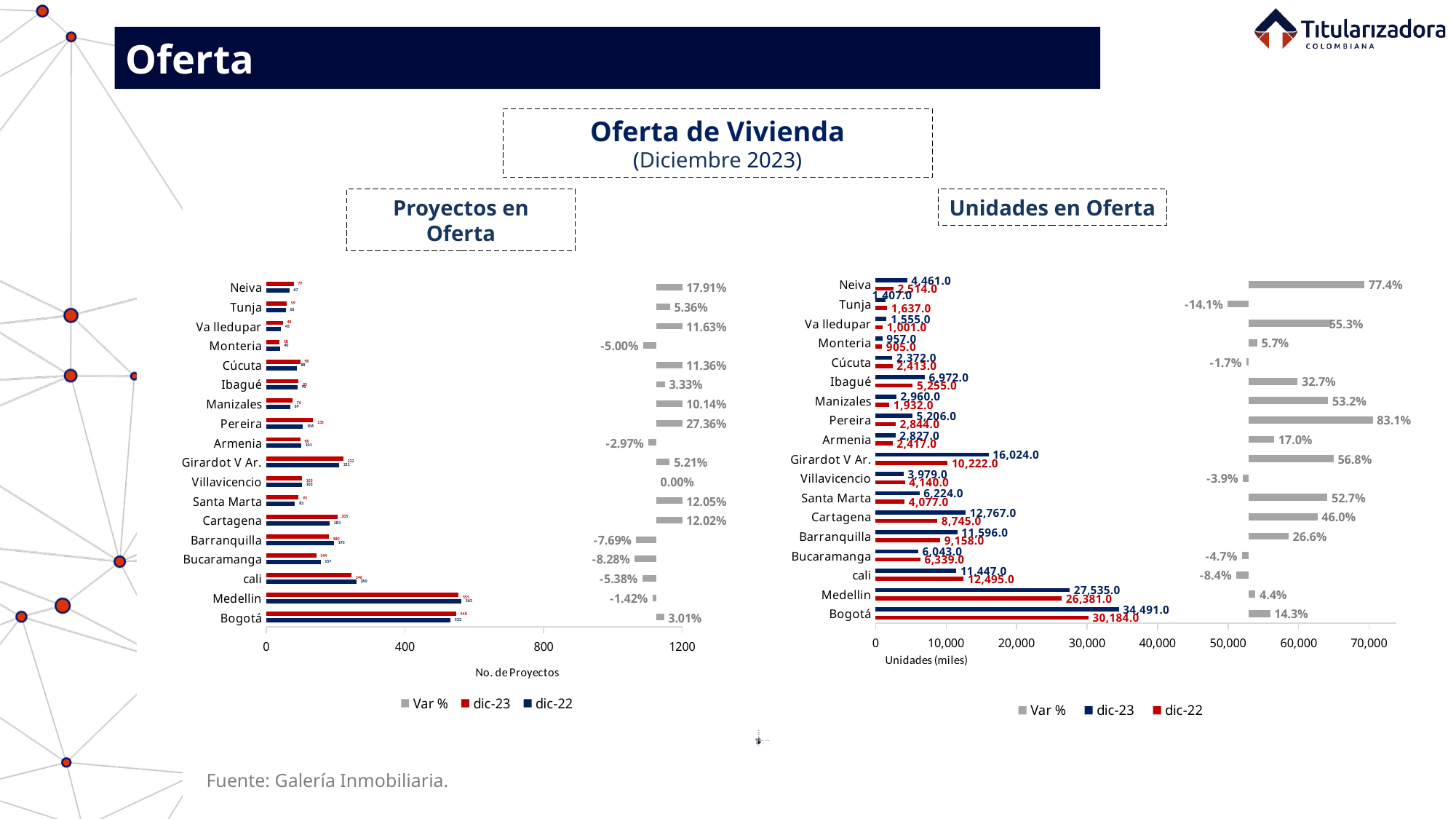
In the Unidades en Oferta chart, what is the Var % for Pereira? 83.1% How many cities are listed in the Proyectos en Oferta chart? 18 In the Unidades en Oferta chart, what is the dic-22 value for Medellin? 26,381.0 In the Unidades en Oferta chart, which is larger for cali: the dic-23 value or the dic-22 value? dic-22 In the Unidades en Oferta chart, is the dic-23 value for Girardot V Ar. greater or less than 20,000? less What kind of chart is the Proyectos en Oferta chart? Bar chart In the Unidades en Oferta chart, what is the dic-23 value for Bogotá? 34,491.0 In the Unidades en Oferta chart, what is the difference between the dic-23 and dic-22 values for Cartagena? 4,022.0 How many series does the legend of the Unidades en Oferta chart list? 3 In the Proyectos en Oferta chart, what is the Var % for Neiva? 17.91% In the Unidades en Oferta chart, which city has the lowest Var %? Tunja In the Unidades en Oferta chart, which city has the highest dic-23 value? Bogotá